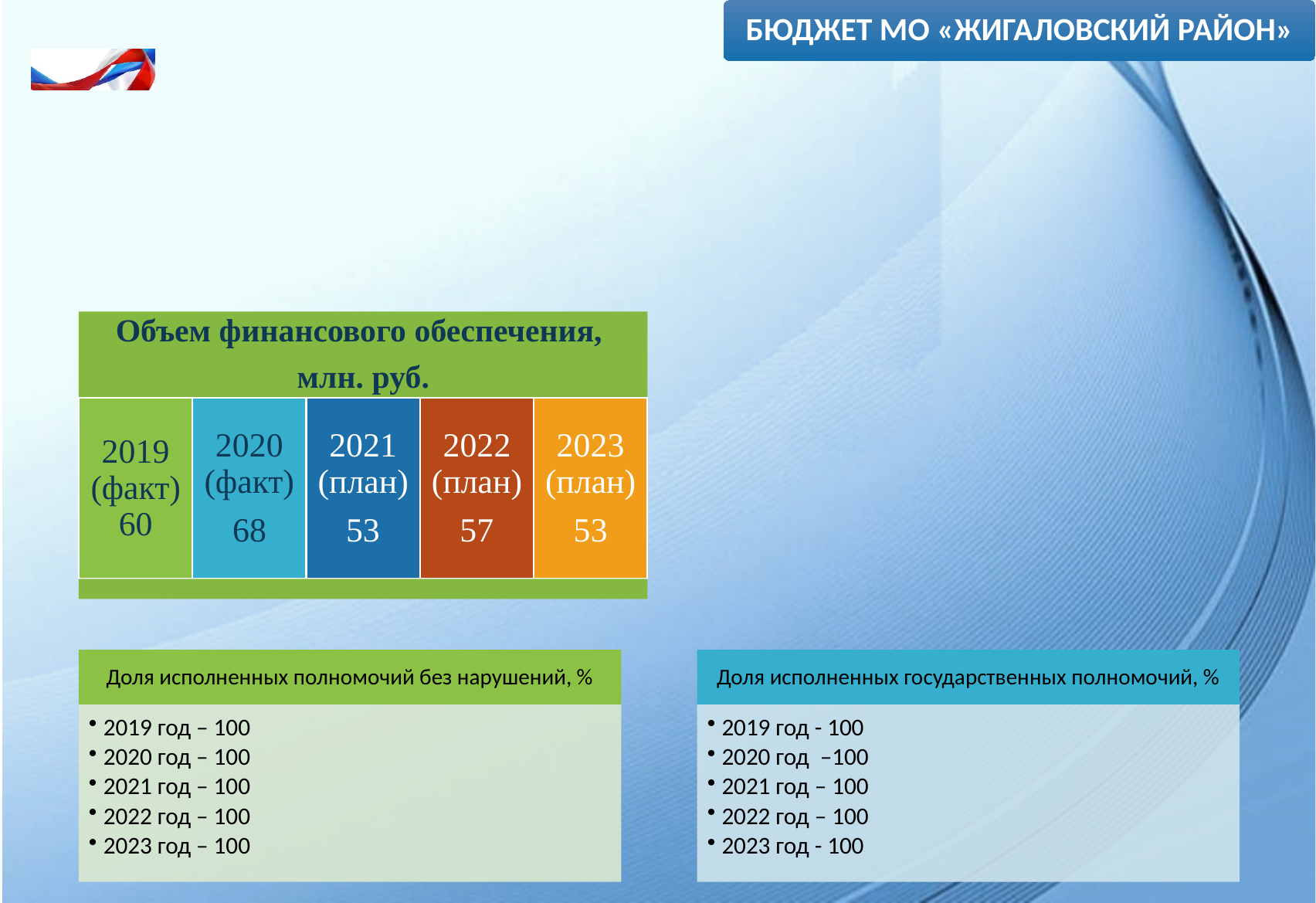
In the "Объем финансового обеспечения, млн. руб." chart, which is larger: the value for 2022 (план) or 2023 (план)? 2022 (план) In the "Объем финансового обеспечения, млн. руб." chart, what colour is the block for 2022 (план)? Brown (dark orange) In the "Объем финансового обеспечения, млн. руб." chart, what unit are the values given in? млн. руб. In the "Объем финансового обеспечения, млн. руб." chart, what is the planned value for 2023? 53 In the "Объем финансового обеспечения, млн. руб." chart, what is the value for 2020 (факт)? 68 In the "Объем финансового обеспечения, млн. руб." chart, which year has the highest value? 2020 (факт) In the "Объем финансового обеспечения, млн. руб." chart, how many years are marked as "план"? 3 In the "Объем финансового обеспечения, млн. руб." chart, what is the planned value for 2022? 57 In the "Объем финансового обеспечения, млн. руб." chart, what is the value for 2019 (факт)? 60 In the "Объем финансового обеспечения, млн. руб." chart, what is the difference between the 2020 (факт) value and the 2021 (план) value? 15 In the "Объем финансового обеспечения, млн. руб." chart, what is the difference between the 2020 (факт) value and the 2019 (факт) value? 8 In the "Объем финансового обеспечения, млн. руб." chart, how many years are shown? 5